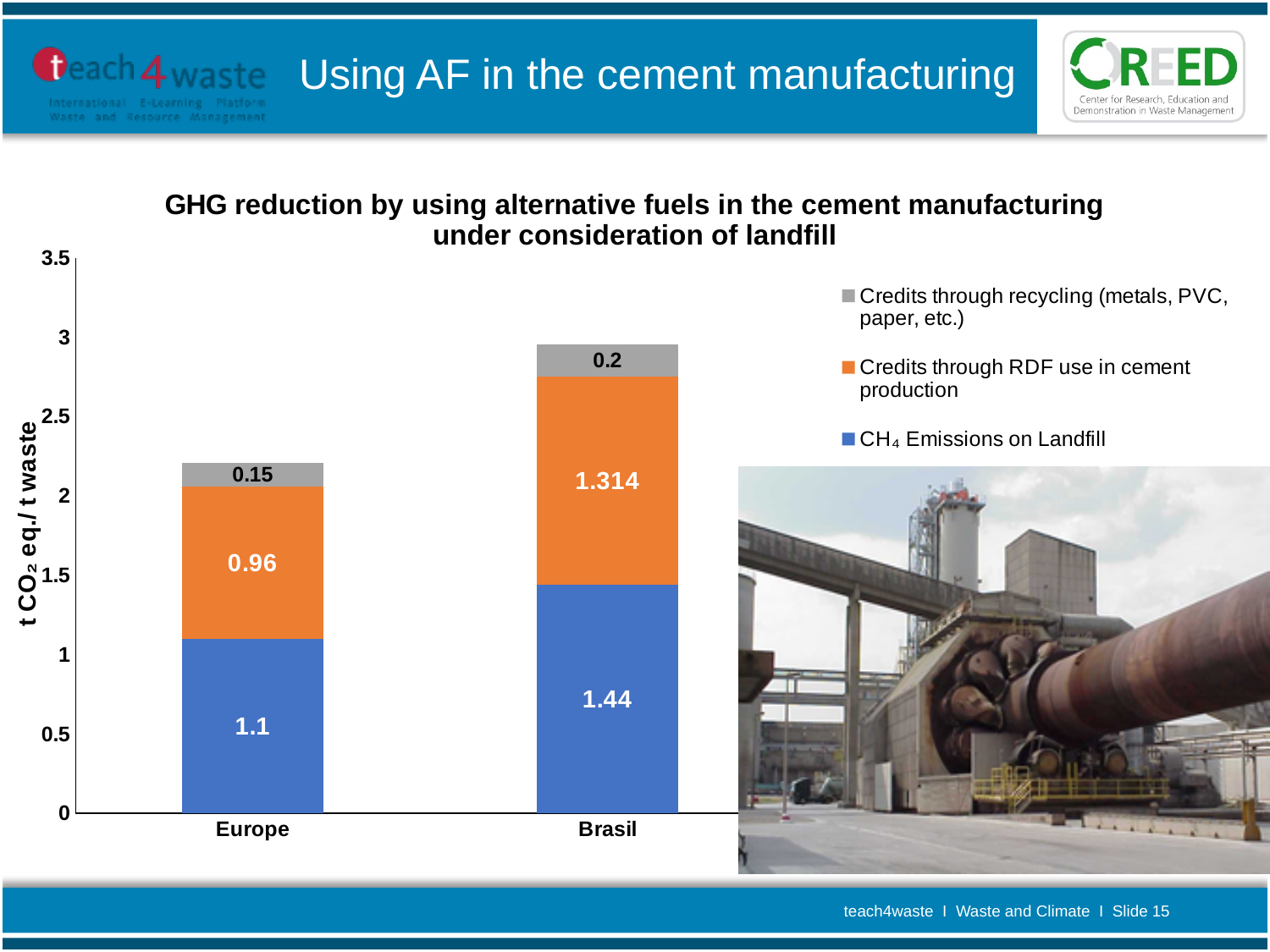
What is the total of the stacked bar for Brasil? 2.954 What is the value of Credits through recycling (metals, PVC, paper, etc.) for Europe? 0.15 What is the value of CH4 Emissions on Landfill for Brasil? 1.44 How many series does the legend list? 3 What is the value of CH4 Emissions on Landfill for Europe? 1.1 What is the difference between the CH4 Emissions on Landfill values for Brasil and Europe? 0.34 How many categories are shown on the x axis? 2 What type of chart is shown on the slide? Stacked bar chart What is the total of the stacked bar for Europe? 2.21 What is the value of Credits through RDF use in cement production for Brasil? 1.314 What is the label of the y axis? t CO2 eq./ t waste Which category has the higher value for Credits through RDF use in cement production, Europe or Brasil? Brasil